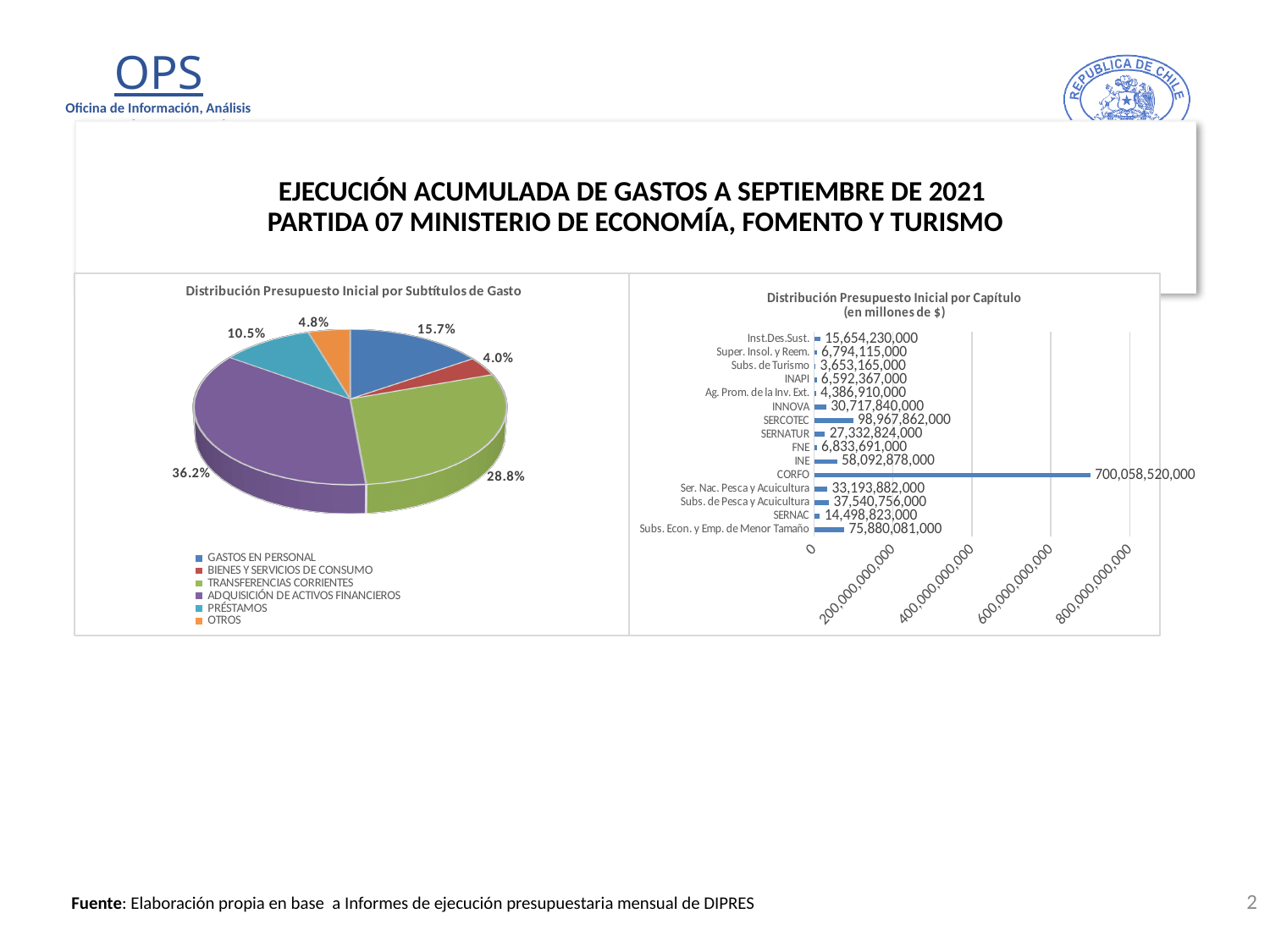
In the bar chart 'Distribución Presupuesto Inicial por Capítulo', which is larger, INE or INNOVA? INE In the bar chart 'Distribución Presupuesto Inicial por Capítulo', which capítulo has the lowest value? Subs. de Turismo In the pie chart 'Distribución Presupuesto Inicial por Subtítulos de Gasto', what is the difference in percentage points between TRANSFERENCIAS CORRIENTES and PRÉSTAMOS? 18.3 In the bar chart 'Distribución Presupuesto Inicial por Capítulo', how many capítulos are shown? 15 In the pie chart 'Distribución Presupuesto Inicial por Subtítulos de Gasto', what share does GASTOS EN PERSONAL have? 15.7% In the pie chart 'Distribución Presupuesto Inicial por Subtítulos de Gasto', how many categories does the legend list? 6 In the pie chart 'Distribución Presupuesto Inicial por Subtítulos de Gasto', which category has the largest share? ADQUISICIÓN DE ACTIVOS FINANCIEROS What type of chart is 'Distribución Presupuesto Inicial por Capítulo'? Bar chart In the pie chart 'Distribución Presupuesto Inicial por Subtítulos de Gasto', what share does ADQUISICIÓN DE ACTIVOS FINANCIEROS have? 36.2% In the pie chart 'Distribución Presupuesto Inicial por Subtítulos de Gasto', which category has the smallest share? BIENES Y SERVICIOS DE CONSUMO In the bar chart 'Distribución Presupuesto Inicial por Capítulo', what is the value for SERCOTEC? 98,967,862,000 In the bar chart 'Distribución Presupuesto Inicial por Capítulo', what is the value for CORFO? 700,058,520,000